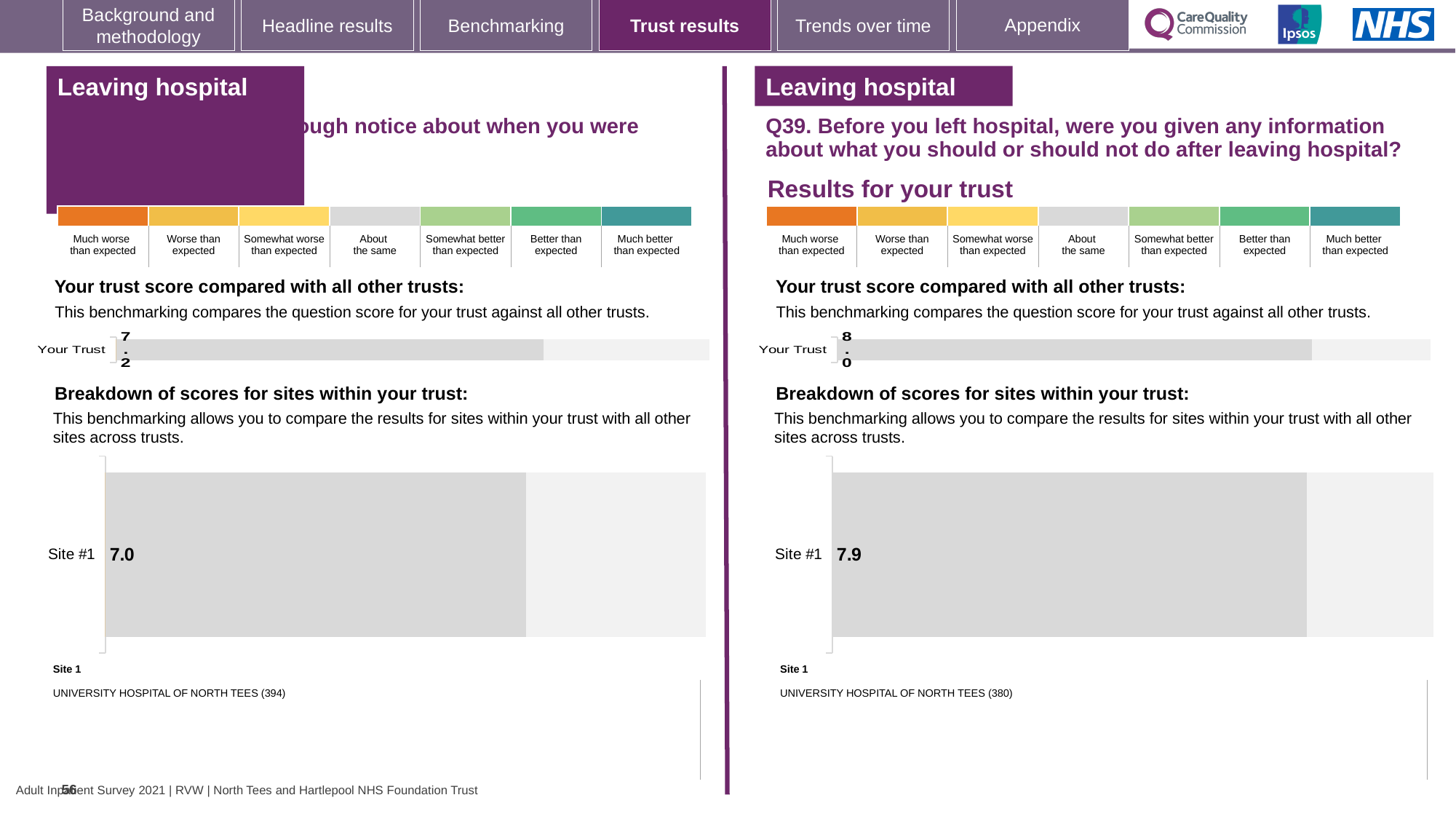
On the right half of the slide (Q39), what is the 'Your Trust' score shown in the trust comparison chart? 8.0 What is the difference between the 'Your Trust' score on the right half (Q39) and the 'Your Trust' score on the left half of the slide? 0.8 On the right half of the slide (Q39), what is the difference between the 'Your Trust' score and the Site #1 score? 0.1 On the left half of the slide, what is the difference between the 'Your Trust' score and the Site #1 score? 0.2 What kind of chart is used to show the Site #1 score on the left half of the slide? Bar chart On the left half of the slide, what is the 'Your Trust' score shown in the trust comparison chart? 7.2 On the right half of the slide (Q39), which site name is listed as Site 1 below the breakdown chart? UNIVERSITY HOSPITAL OF NORTH TEES (380) On the right half of the slide (Q39), what score is shown for Site #1 in the breakdown of scores for sites chart? 7.9 How many sites are plotted in the breakdown of scores for sites chart on the right half of the slide (Q39)? 1 Which is larger: the Site #1 score on the left half of the slide or the Site #1 score on the right half (Q39)? Site #1 on the right half (Q39) On the left half of the slide, what score is shown for Site #1 in the breakdown of scores for sites chart? 7.0 Which is larger: the 'Your Trust' score on the left half of the slide or the 'Your Trust' score on the right half (Q39)? Your Trust on the right half (Q39)